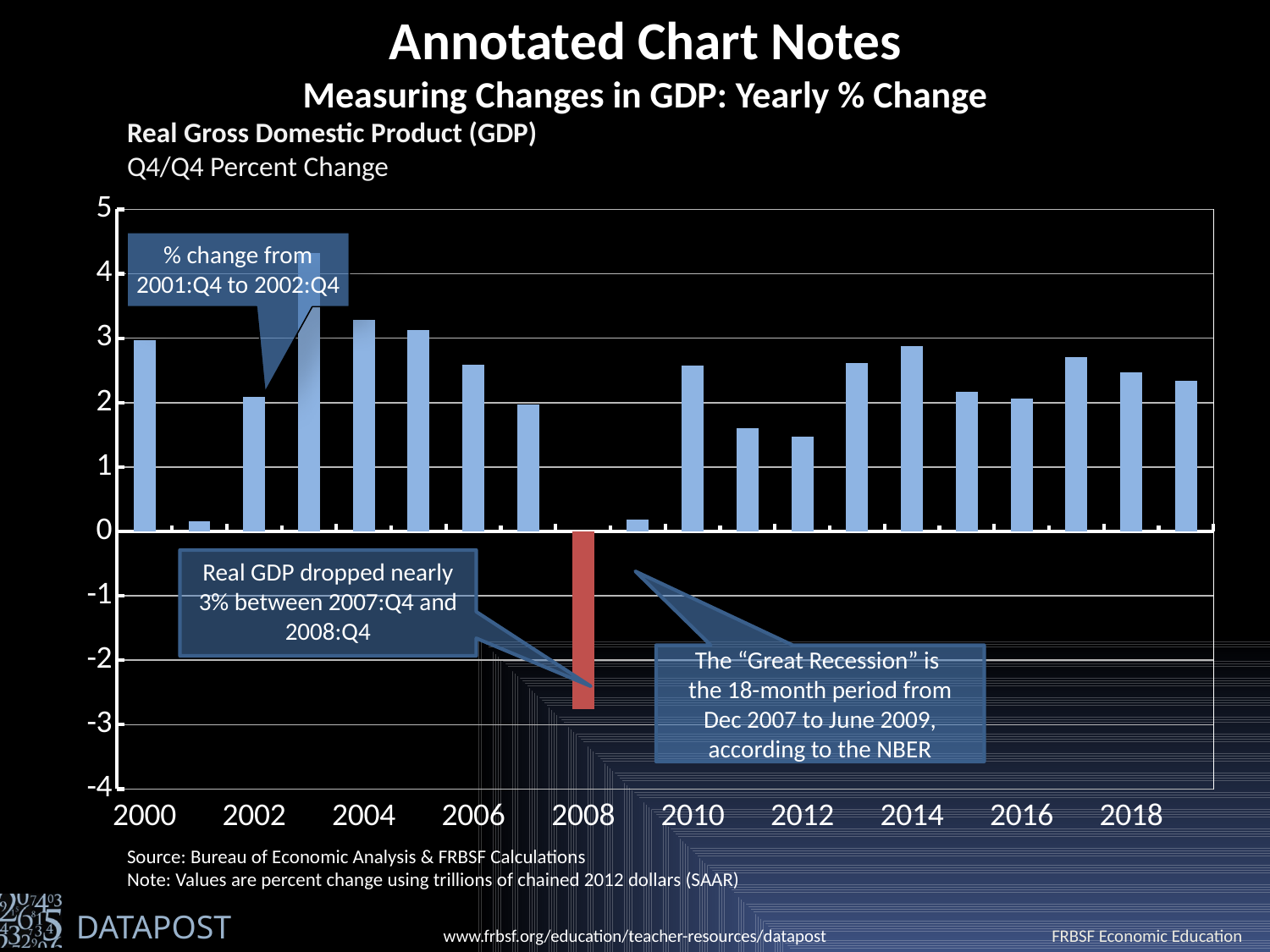
Which year's bar is shown in red rather than blue? 2008 How many years (bars) are plotted in the chart? 20 Which year has the highest Q4/Q4 percent change in real GDP? 2003 What kind of chart is shown on the slide? bar chart Is the value for 2012 greater or less than 2? less Is the value for 2003 greater or less than 4? greater Is the value for 2014 greater or less than 2? greater Which year has the larger value, 2004 or 2007? 2004 Which year has the larger value, 2011 or 2017? 2017 Which year has the lowest Q4/Q4 percent change in real GDP? 2008